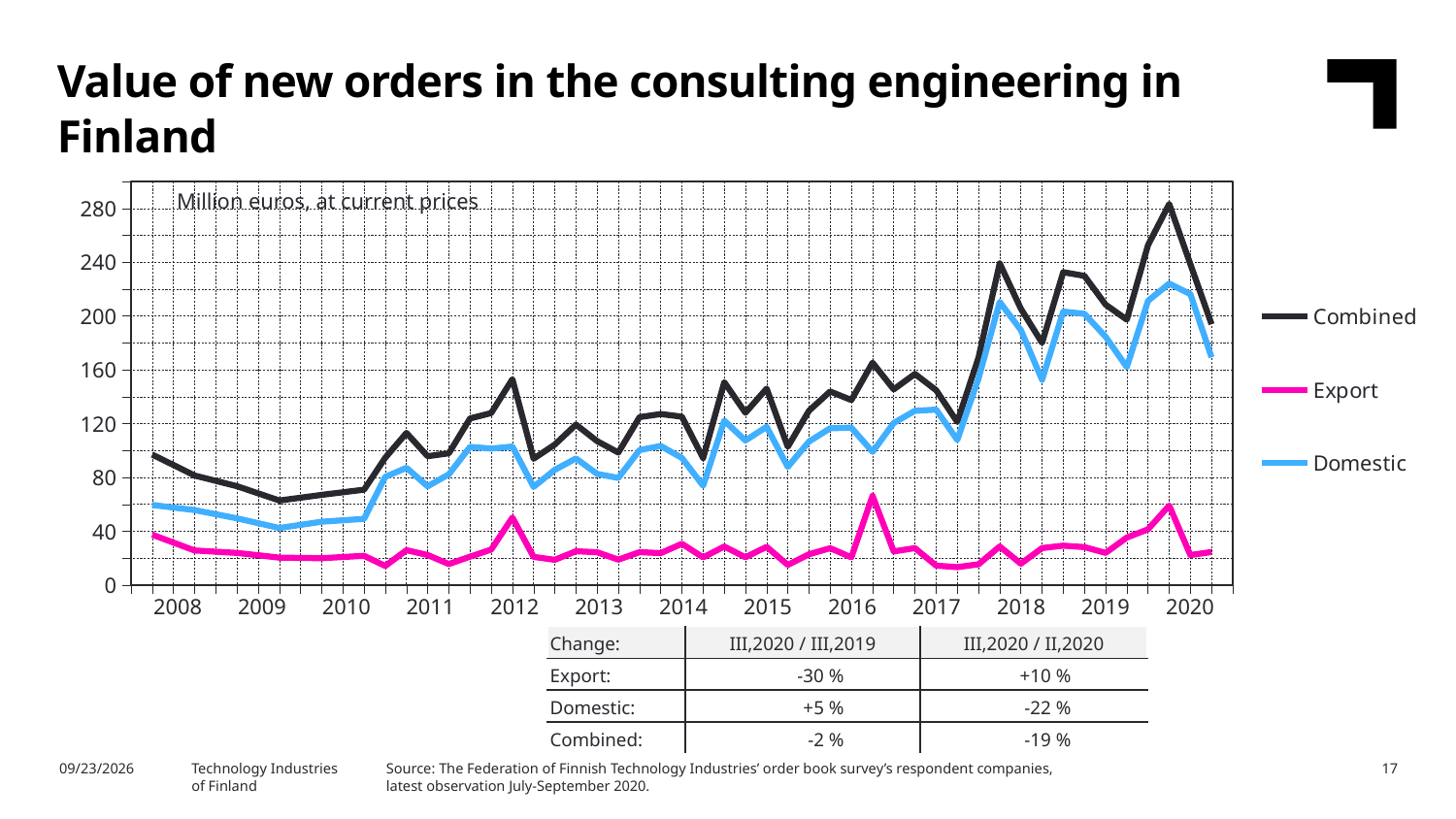
Which series reaches the highest value on the chart? Combined What unit is stated for the values on the chart? Million euros, at current prices Is the peak value of the Combined series in late 2019 greater or less than 240? greater How many series does the legend list? 3 In 2018, which is larger, the Domestic value or the Export value? Domestic Which series has the lowest values throughout the chart? Export What kind of chart is shown on the slide? Line chart Does the Combined series rise or fall from 2008 to 2009? fall Which series does the legend show in black? Combined Is the lowest value of the Combined series in 2009 greater or less than 80? less Is the peak value of the Domestic series in late 2019 greater or less than 200? greater